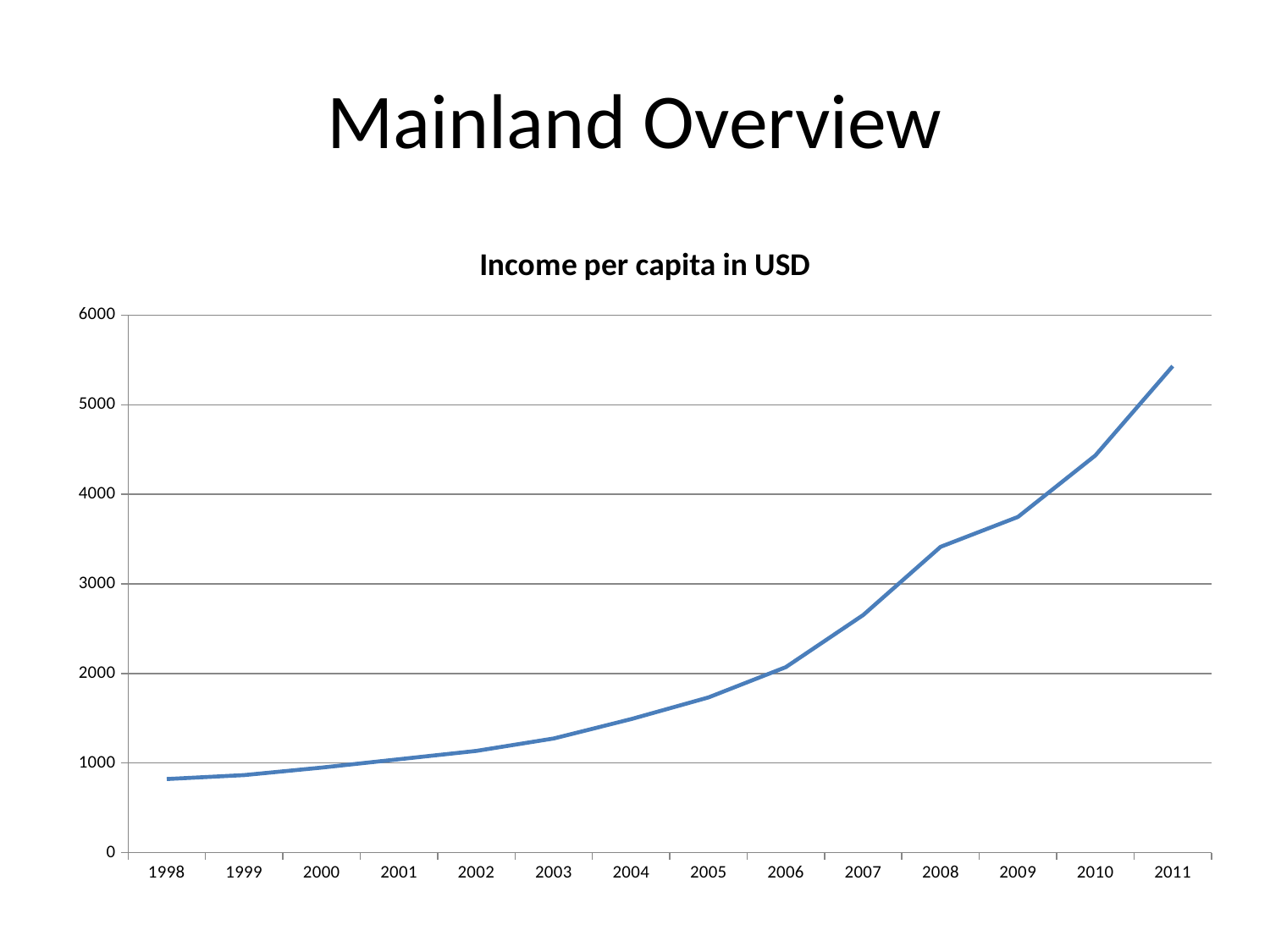
Is the value for 2005 greater or less than 2000? less Is the value for 1998 greater or less than 1000? less Is the value for 2008 greater or less than 3000? greater How many years are plotted on the x axis of the chart? 14 What type of chart is shown on the slide? line chart Which year has the larger income per capita, 2005 or 2010? 2010 Which year has the highest income per capita? 2011 What is the title of the chart? Income per capita in USD Do the values rise or fall from 1998 to 2011? rise Which year has the lowest income per capita? 1998